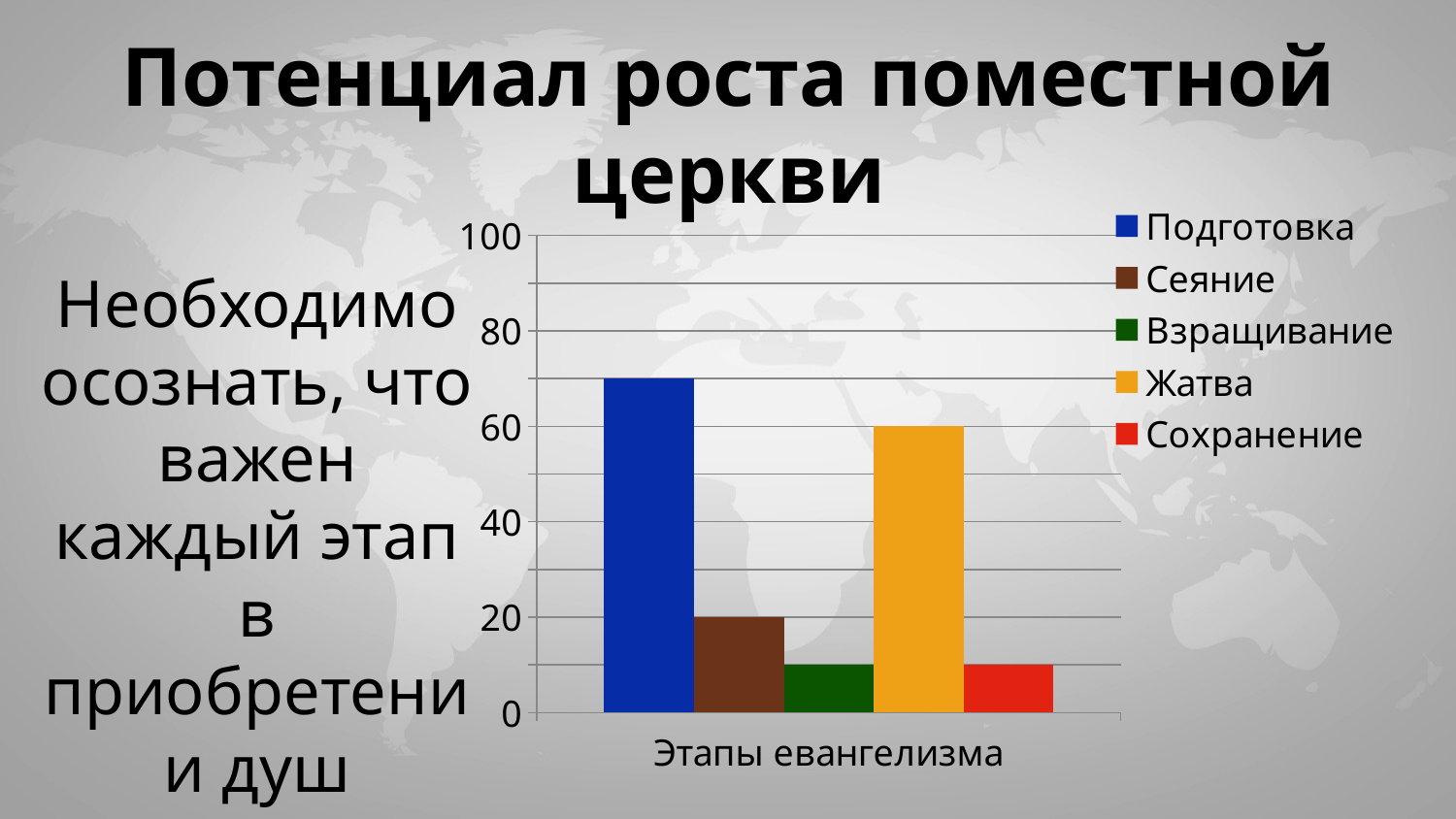
What is the difference between the values for Жатва and Сеяние? 40 How many series does the chart legend list? 5 What kind of chart is shown on the slide? bar chart Which is larger, the value for Подготовка or the value for Жатва? Подготовка Is the value for Взращивание greater or less than 20? less How many categories are shown on the x axis of the chart? 1 What is the label shown on the x axis of the chart? Этапы евангелизма What is the value for Жатва? 60 What is the value for Сеяние? 20 Which series has the highest value in the chart? Подготовка Is the value for Сохранение greater or less than 20? less Is the value for Подготовка greater or less than 60? greater